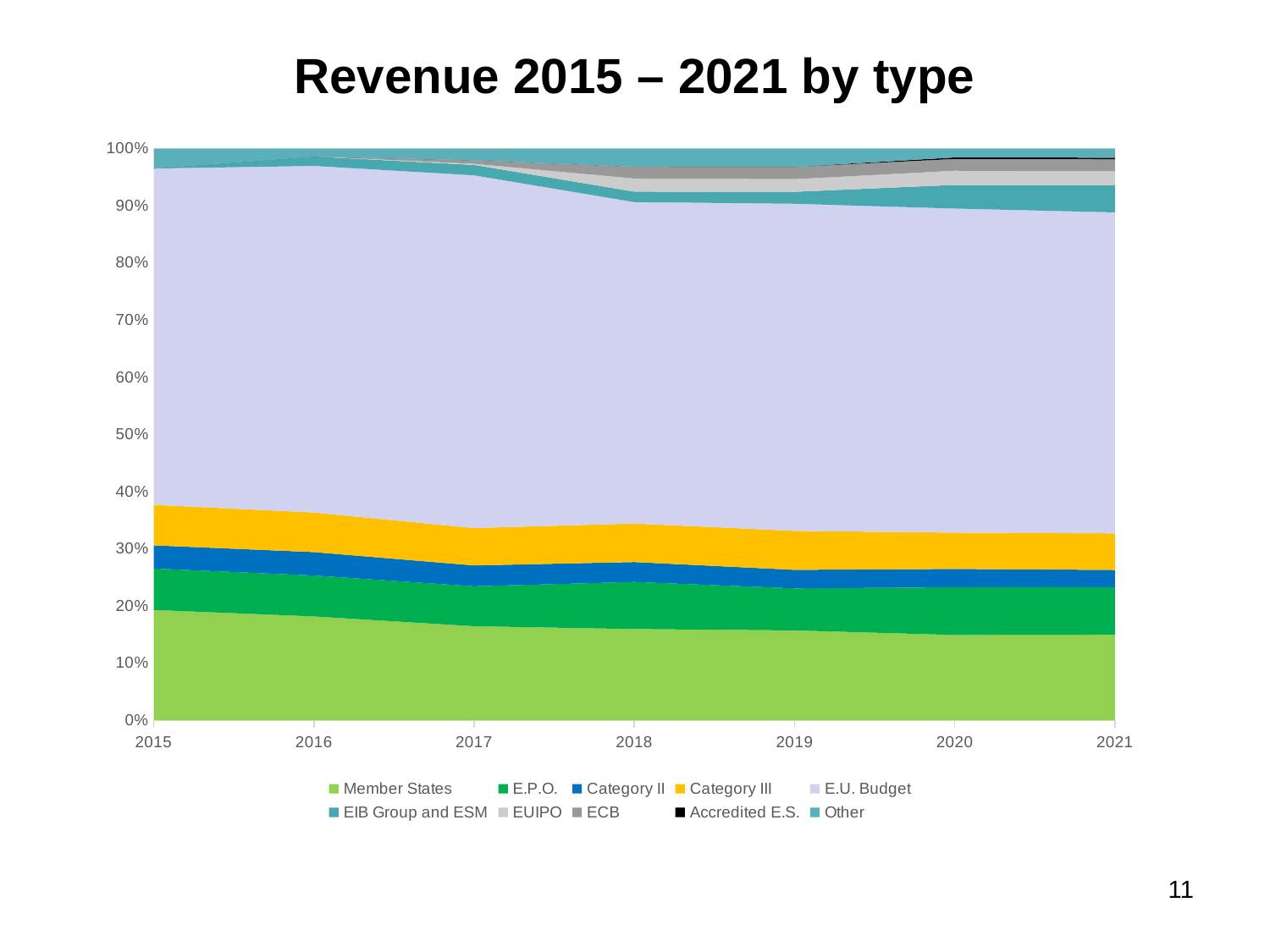
What is the title of the chart? Revenue 2015 – 2021 by type Is the share for Member States in 2021 greater or less than 20%? less What kind of chart is shown on the slide? Stacked area chart Which revenue type accounts for the largest share in 2021? E.U. Budget Which series is shown in black in the legend? Accredited E.S. Is the share for Member States in 2015 greater or less than 10%? greater In 2015, which is larger: the share of Member States or the share of E.P.O.? Member States Does the share of Member States rise or fall from 2015 to 2021? Fall What is the first year shown on the x axis? 2015 What is the highest value shown on the y axis? 100% How many series does the legend list? 10 How many years are shown along the x axis? 7